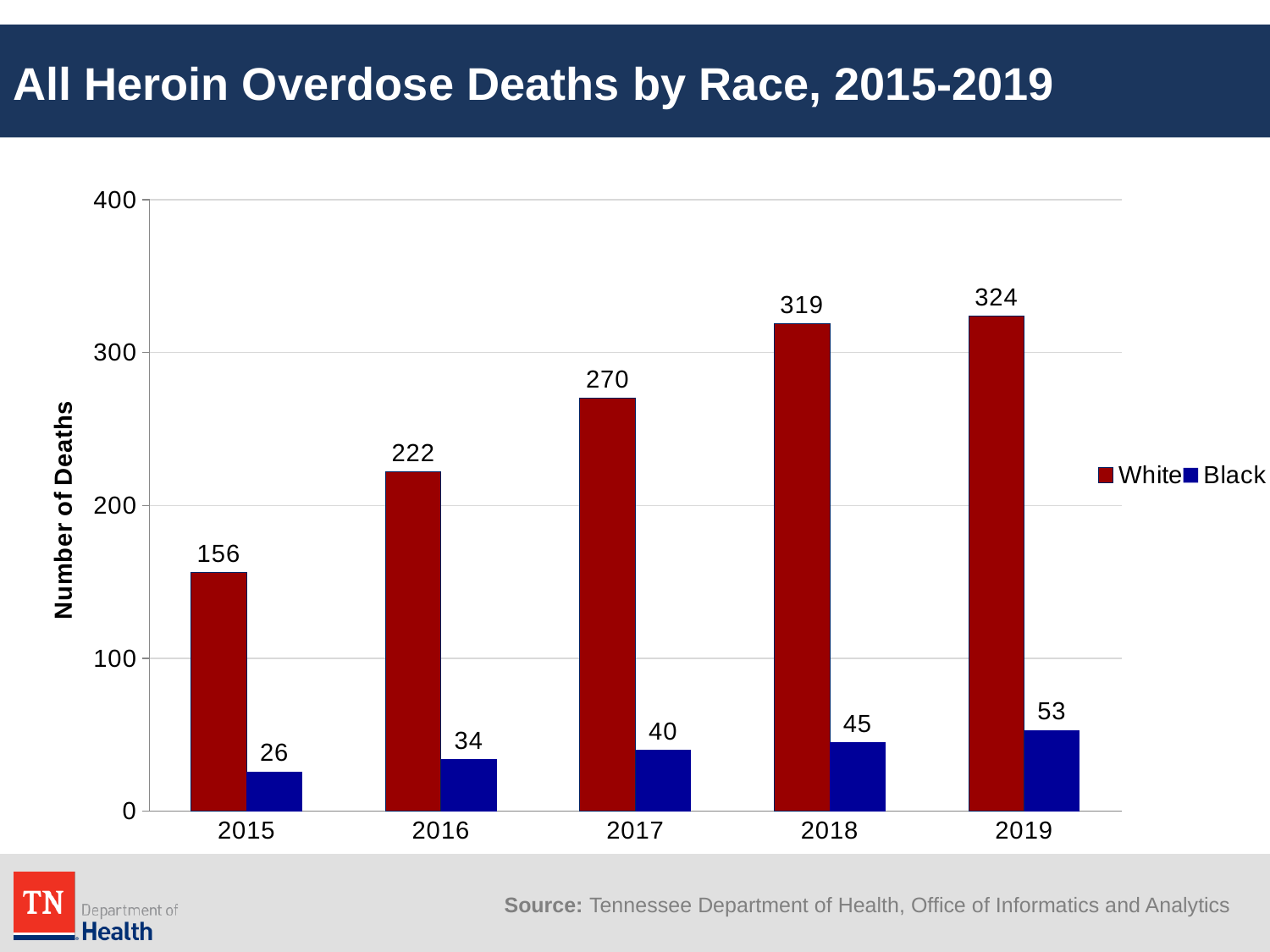
What kind of chart is shown on the slide? Bar chart Which is larger: Black deaths in 2018 or Black deaths in 2016? Black deaths in 2018 How many series does the legend list? 2 In which year was the number of deaths for the White series highest? 2019 How many heroin overdose deaths among White individuals were there in 2017? 270 Is the value for White deaths in 2018 greater or less than 300? greater How many heroin overdose deaths among Black individuals were there in 2015? 26 By how much did White heroin overdose deaths increase from 2015 to 2016? 66 Do the Black heroin overdose deaths rise or fall from 2015 to 2019? Rise What is the difference between White and Black heroin overdose deaths in 2019? 271 How many years are shown on the x axis? 5 In which year was the number of deaths for the Black series lowest? 2015